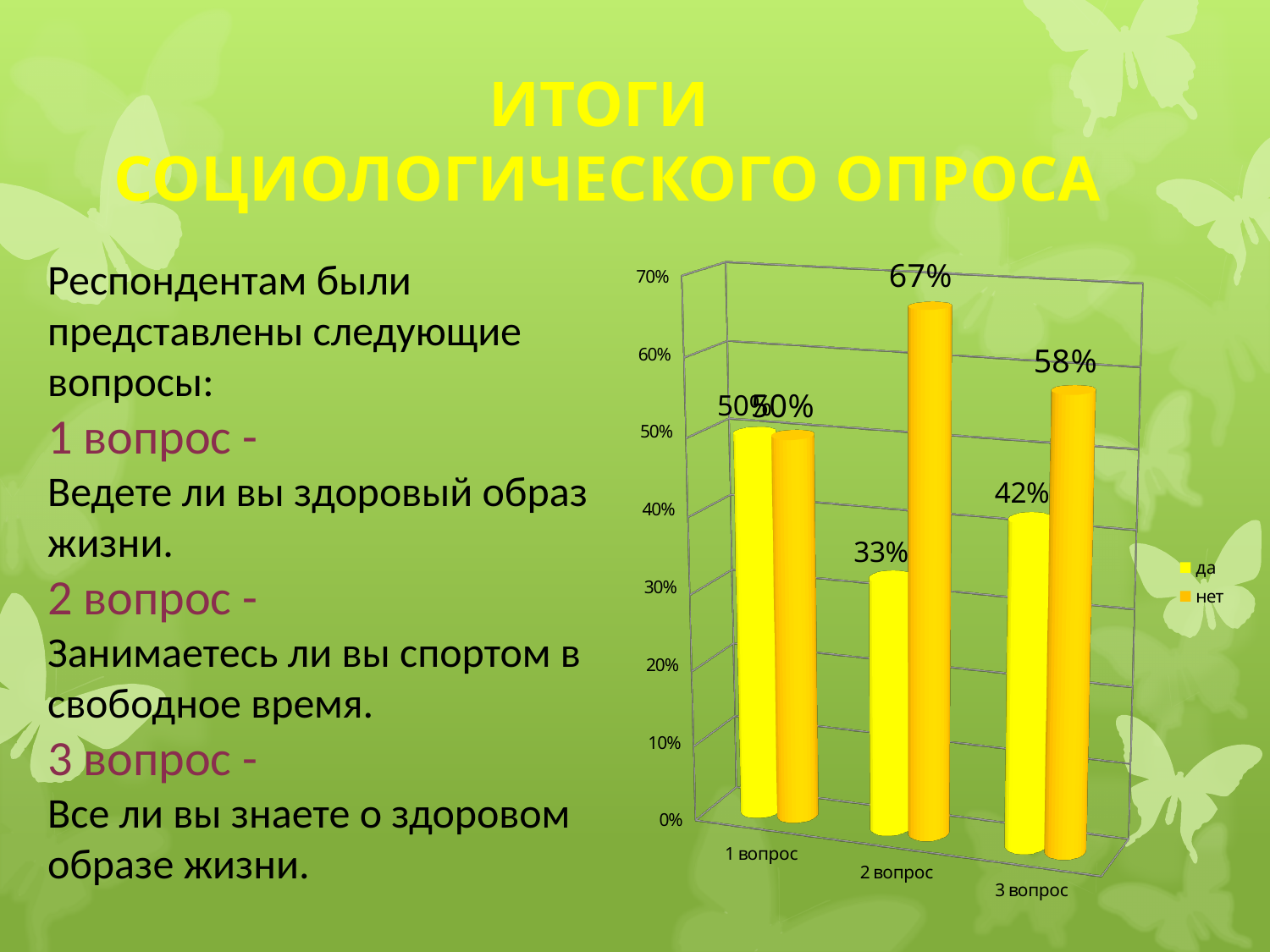
Which is larger for "3 вопрос": "да" or "нет"? нет What is the value of "да" for "3 вопрос"? 42% For which category is the "нет" value highest? 2 вопрос How many series does the chart legend list? 2 What is the value of "нет" for "2 вопрос"? 67% What is the value of "нет" for "3 вопрос"? 58% What kind of chart is shown on the slide? bar chart How many categories are shown on the x axis of the chart? 3 What is the difference between the "нет" and "да" values for "2 вопрос"? 34% For which category is the "да" value lowest? 2 вопрос Which series is shown in orange in the chart legend? нет What is the value of "да" for "2 вопрос"? 33%